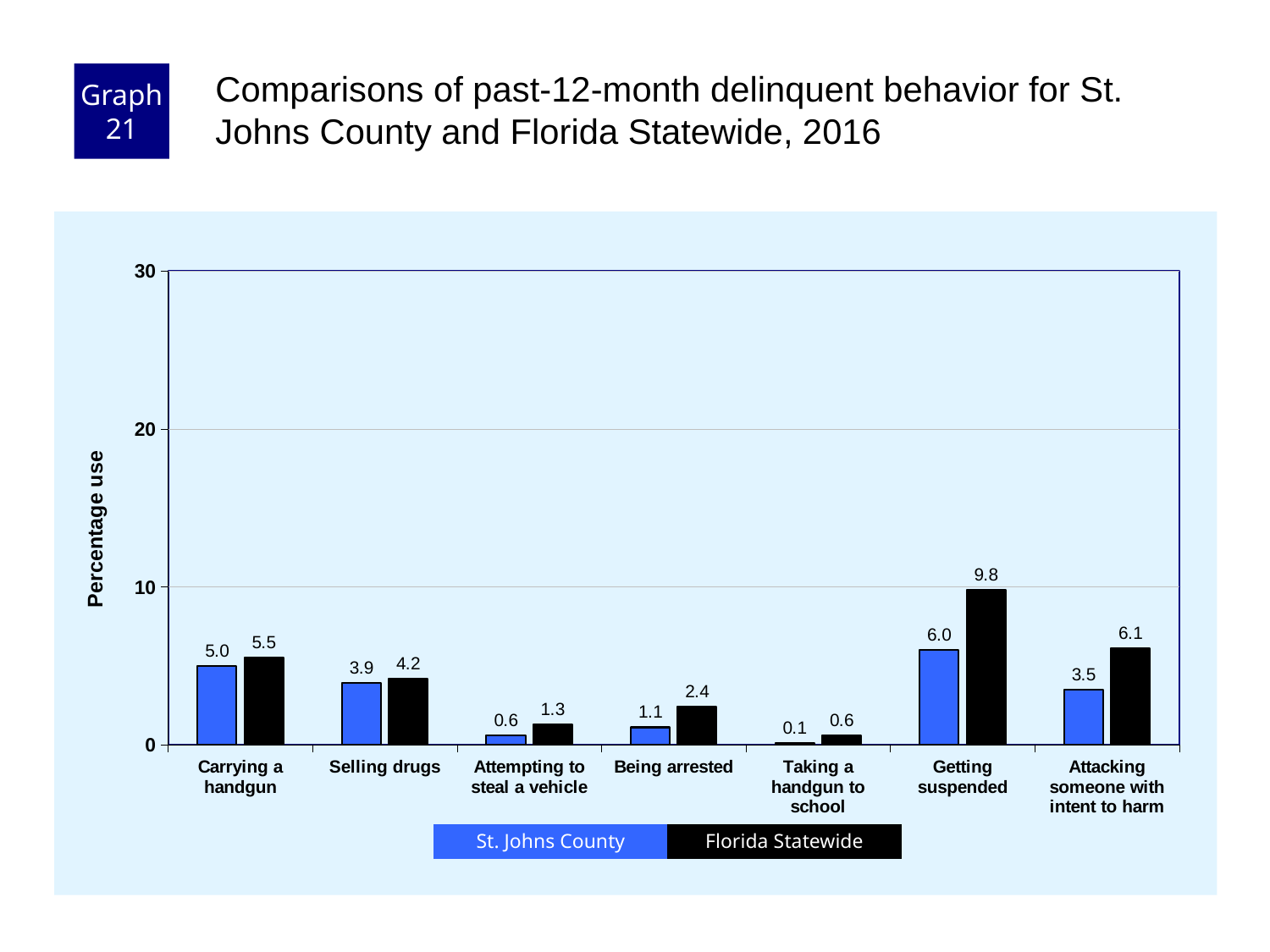
How many behavior categories are shown on the x axis? 7 What is the difference between the Florida Statewide and St. Johns County values for Attacking someone with intent to harm? 2.6 Which category has the lowest St. Johns County value? Taking a handgun to school What is the St. Johns County value for Getting suspended? 6.0 Is the Florida Statewide value for Getting suspended greater or less than 10? less Which category has the highest Florida Statewide value? Getting suspended What is the St. Johns County value for Taking a handgun to school? 0.1 Which is larger for Selling drugs: the St. Johns County value or the Florida Statewide value? Florida Statewide What type of chart is shown on the slide? bar chart How many series does the legend list? 2 What is the Florida Statewide value for Being arrested? 2.4 What is the difference between the Florida Statewide and St. Johns County values for Getting suspended? 3.8